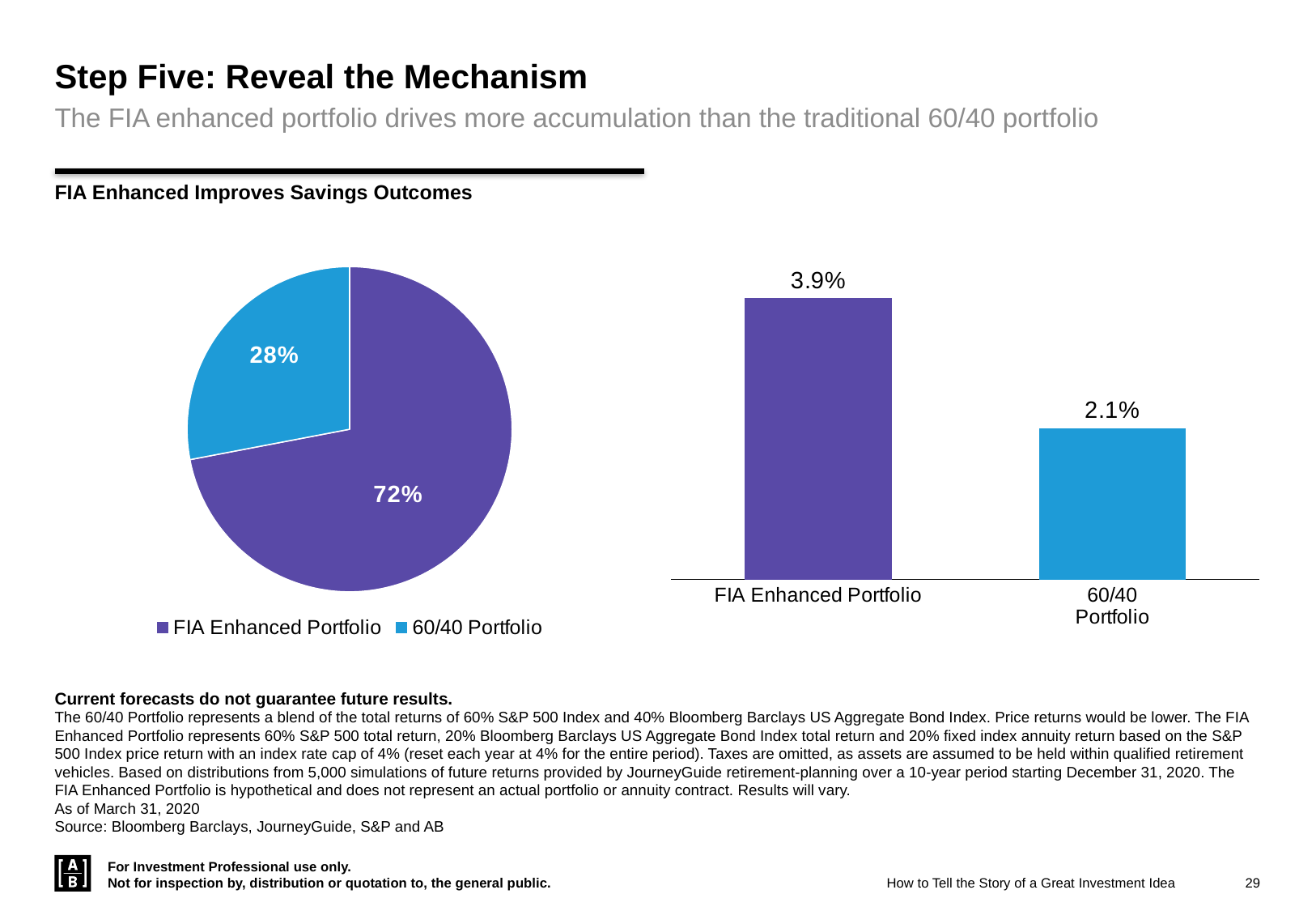
In the pie chart on the left, what colour is the 60/40 Portfolio slice? Blue In the pie chart on the left, what share does the FIA Enhanced Portfolio slice represent? 72% In the bar chart on the right, what is the difference between the FIA Enhanced Portfolio and 60/40 Portfolio values? 1.8% In the pie chart on the left, what share does the 60/40 Portfolio slice represent? 28% In the bar chart on the right, what is the value for 60/40 Portfolio? 2.1% In the pie chart on the left, how many slices are there? 2 What kind of chart is the chart on the left? Pie chart In the bar chart on the right, what is the value for FIA Enhanced Portfolio? 3.9% In the pie chart on the left, how many entries does the legend list? 2 What kind of chart is the chart on the right? Bar chart In the bar chart on the right, which category has the highest value? FIA Enhanced Portfolio In the pie chart on the left, which slice is larger, FIA Enhanced Portfolio or 60/40 Portfolio? FIA Enhanced Portfolio